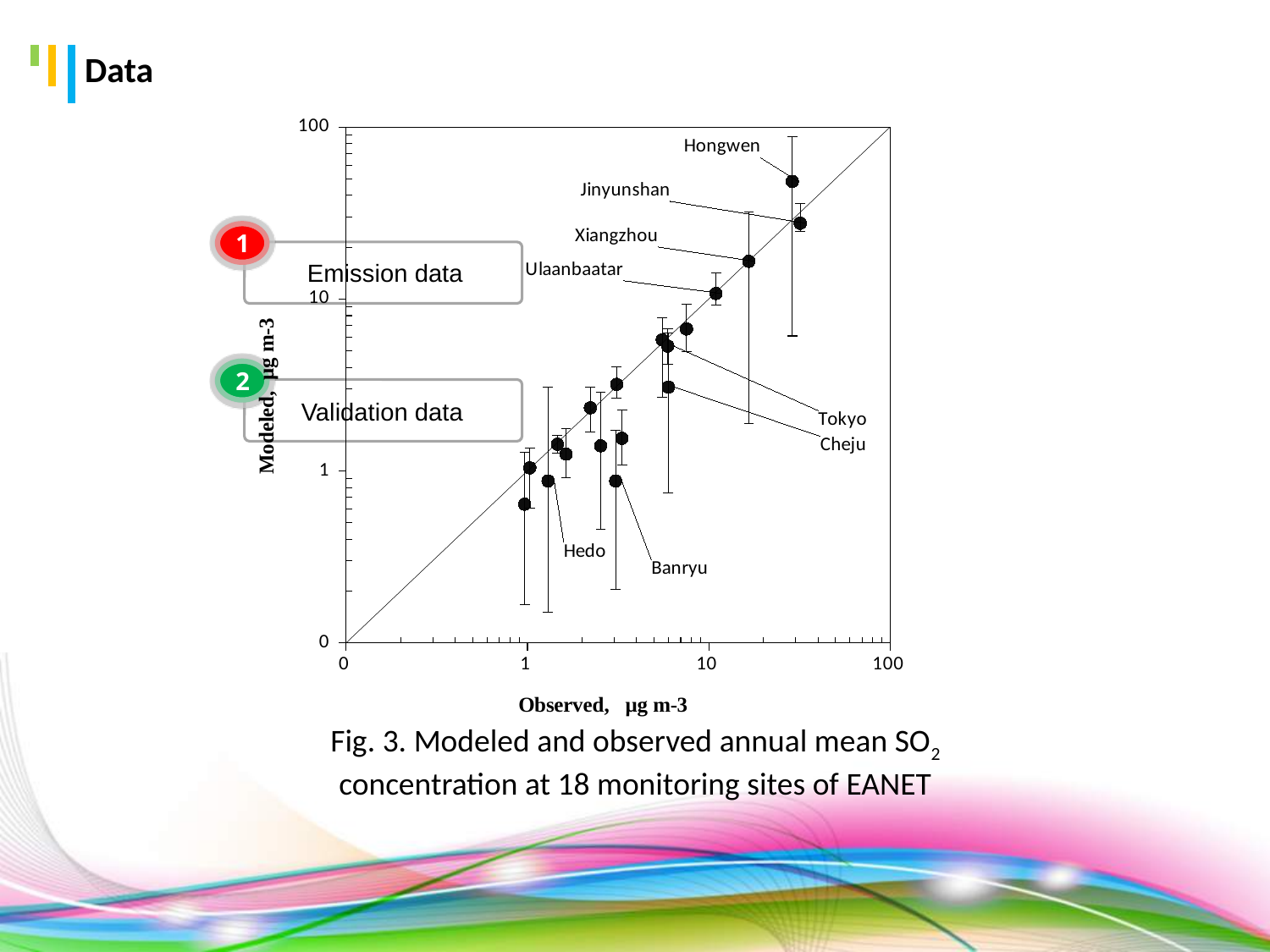
Which has the larger modeled value, Hongwen or Ulaanbaatar? Hongwen Is the observed value for Tokyo greater or less than 10? less What is the label of the x axis? Observed, µg m-3 According to the figure caption, how many EANET monitoring sites are plotted? 18 Is the modeled value for Hedo greater or less than 10? less Is the observed value for Banryu greater or less than 1? greater How many sites are labeled by name on the chart? 8 What kind of chart is shown on the slide? Scatter plot Which labeled site has the highest modeled SO2 concentration? Hongwen